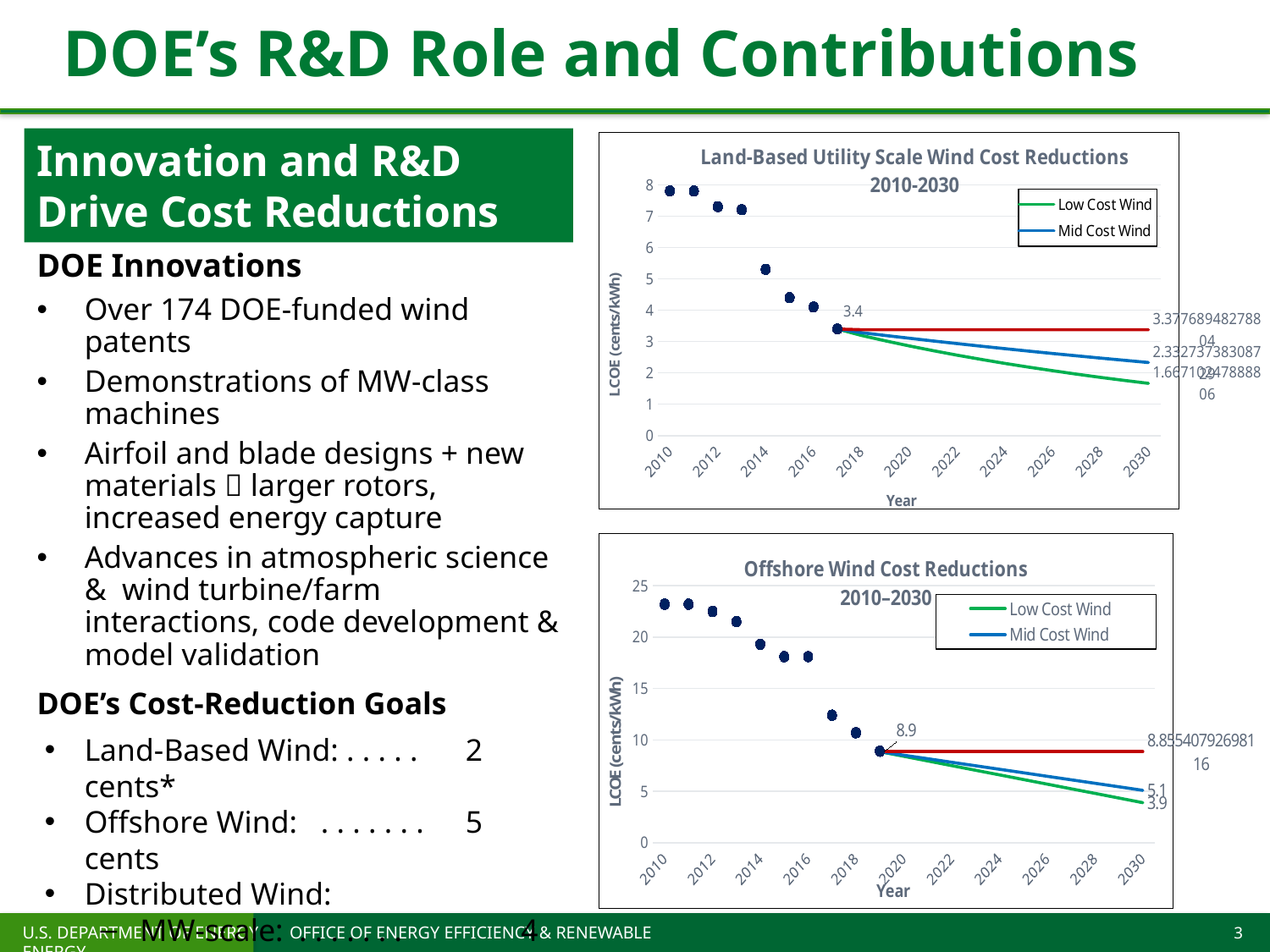
In the Offshore Wind Cost Reductions chart, what labelled value marks the point where the projection lines begin? 8.9 In the Offshore Wind Cost Reductions chart, what is the difference between the Mid Cost Wind and Low Cost Wind values in 2030? 1.2 In the Offshore Wind Cost Reductions chart, which line has the higher value in 2030, Low Cost Wind or Mid Cost Wind? Mid Cost Wind In the Land-Based Utility Scale Wind Cost Reductions chart, is the Low Cost Wind value in 2030 greater or less than 2? less In the Offshore Wind Cost Reductions chart, what is the labelled value of the Mid Cost Wind line in 2030? 5.1 How many series does the legend of the Land-Based Utility Scale Wind Cost Reductions chart list? 2 What is the y-axis label of the Offshore Wind Cost Reductions chart? LCOE (cents/kWh) In the Offshore Wind Cost Reductions chart, what is the labelled value of the Low Cost Wind line in 2030? 3.9 What kind of chart is the Land-Based Utility Scale Wind Cost Reductions chart? line chart In the Land-Based Utility Scale Wind Cost Reductions chart, what labelled value marks the point where the projection lines begin? 3.4 In the Land-Based Utility Scale Wind Cost Reductions chart, is the Mid Cost Wind value in 2030 greater or less than 2? greater In the Offshore Wind Cost Reductions chart, do the plotted values rise or fall from 2010 to 2030? fall